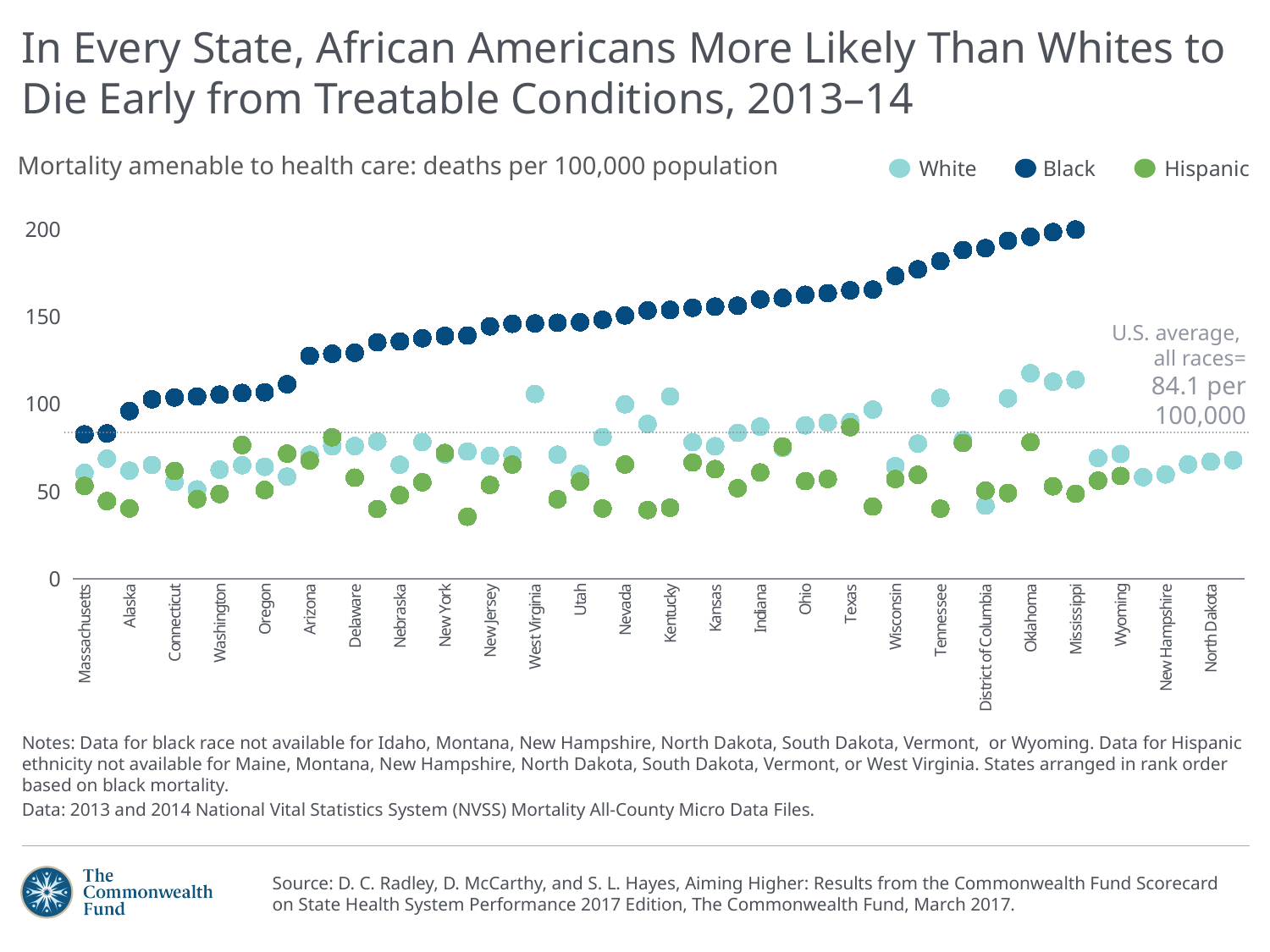
For Mississippi, which is larger: the Black value or the White value? Black Is the Black mortality value for Massachusetts greater or less than 100? less Which colour represents the Hispanic series in the legend? Green Is the Black mortality value for Mississippi greater or less than 150? greater Do the Black mortality values rise or fall from left to right across the states? Rise Is the White mortality value for Oklahoma greater or less than 100? greater How many series does the legend list? 3 Which state has the highest Black mortality value on the chart? Mississippi Which state has the lowest Black mortality value on the chart? Massachusetts What kind of chart is shown on the slide? Scatter (dot) chart What is the U.S. average mortality amenable to health care for all races, as printed on the chart? 84.1 per 100,000